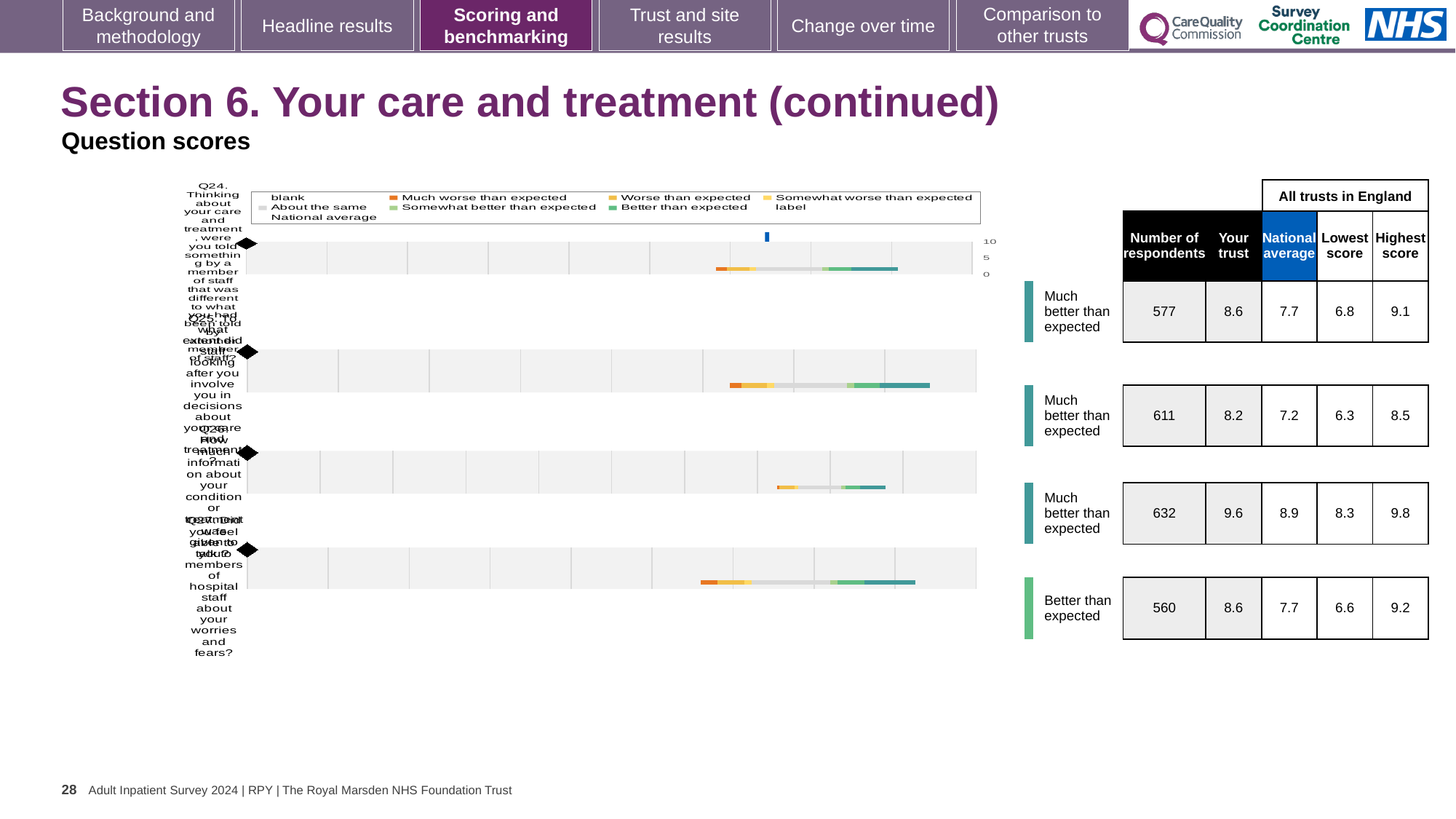
What kind of chart is used for the question scores on the left of the slide? bar chart In the table beside the charts, which is larger in the second row: the 'Your trust' score or the national average? Your trust In the table beside the charts, what is the difference between the 'Your trust' score and the national average in the third row? 0.7 In the table beside the charts, what is the national average in the third row? 8.9 In the chart legend, what colour represents 'Much worse than expected'? orange In the table beside the charts, what is the highest score in the fourth row? 9.2 In the table beside the charts, what is the lowest score in the first row? 6.8 In the table beside the charts, what is the 'Your trust' score in the second row? 8.2 In the table beside the charts, what is the number of respondents in the first row? 577 How many question charts are shown on the left of the slide? 4 In the table beside the charts, which row has the highest 'Your trust' score? third row (9.6) What is the highest tick value shown on the axis of the question charts? 10